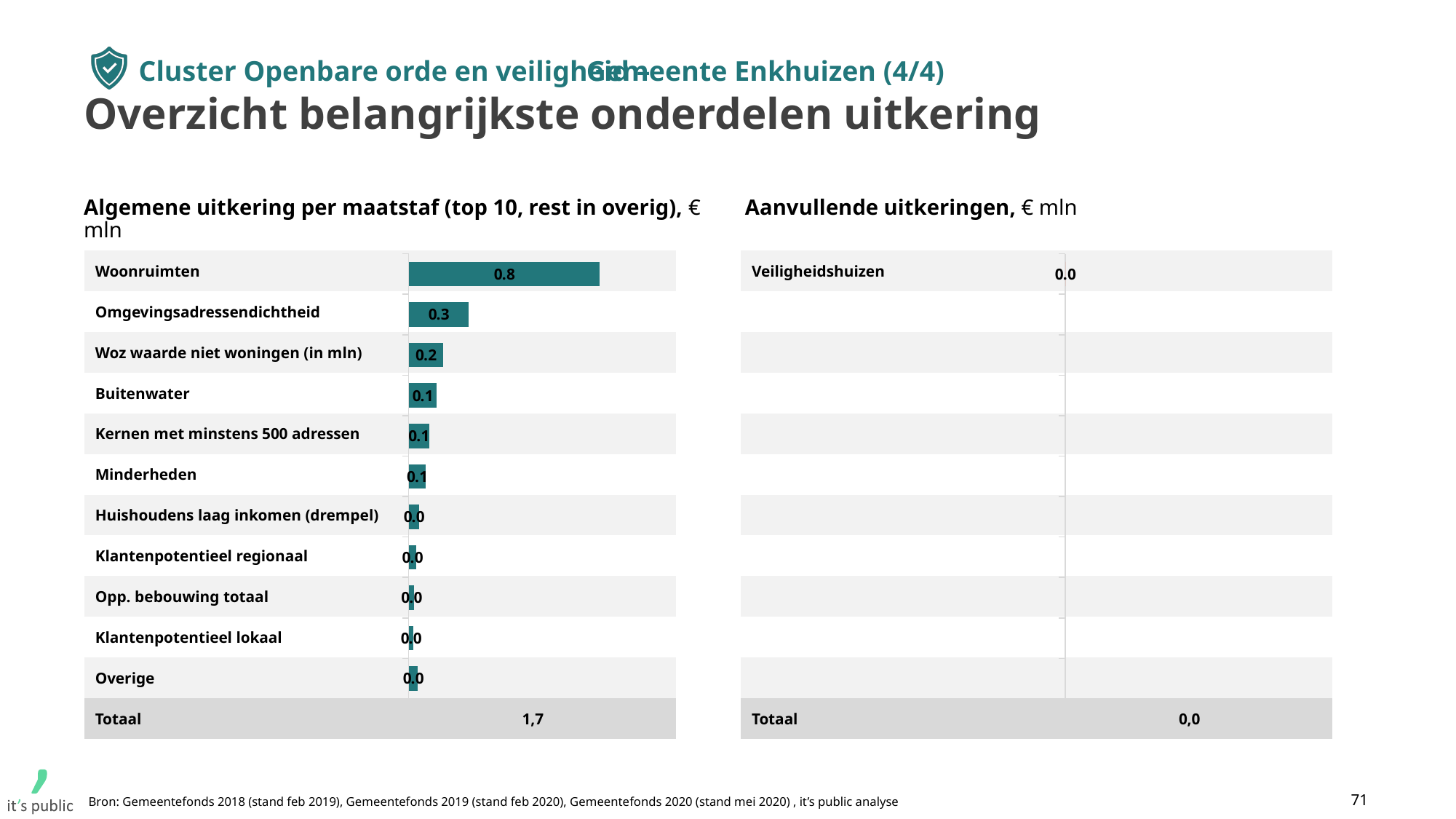
In the 'Algemene uitkering per maatstaf' chart, what is the value for Omgevingsadressendichtheid? 0.3 What is the Totaal shown for the 'Aanvullende uitkeringen' chart? 0,0 In the 'Algemene uitkering per maatstaf' chart, which category has the highest value? Woonruimten In the 'Aanvullende uitkeringen' chart, what is the value for Veiligheidshuizen? 0.0 In the 'Algemene uitkering per maatstaf' chart, what is the value for Woonruimten? 0.8 What is the Totaal shown for the 'Algemene uitkering per maatstaf' chart? 1,7 In the 'Algemene uitkering per maatstaf' chart, what is the value for Woz waarde niet woningen (in mln)? 0.2 What kind of chart is the 'Algemene uitkering per maatstaf' chart? Bar chart In the 'Algemene uitkering per maatstaf' chart, which is larger: Omgevingsadressendichtheid or Buitenwater? Omgevingsadressendichtheid In what unit are the values in the 'Aanvullende uitkeringen' chart expressed? € mln How many categories are shown in the 'Algemene uitkering per maatstaf' chart? 11 In the 'Algemene uitkering per maatstaf' chart, what is the difference between Woonruimten and Omgevingsadressendichtheid? 0.5